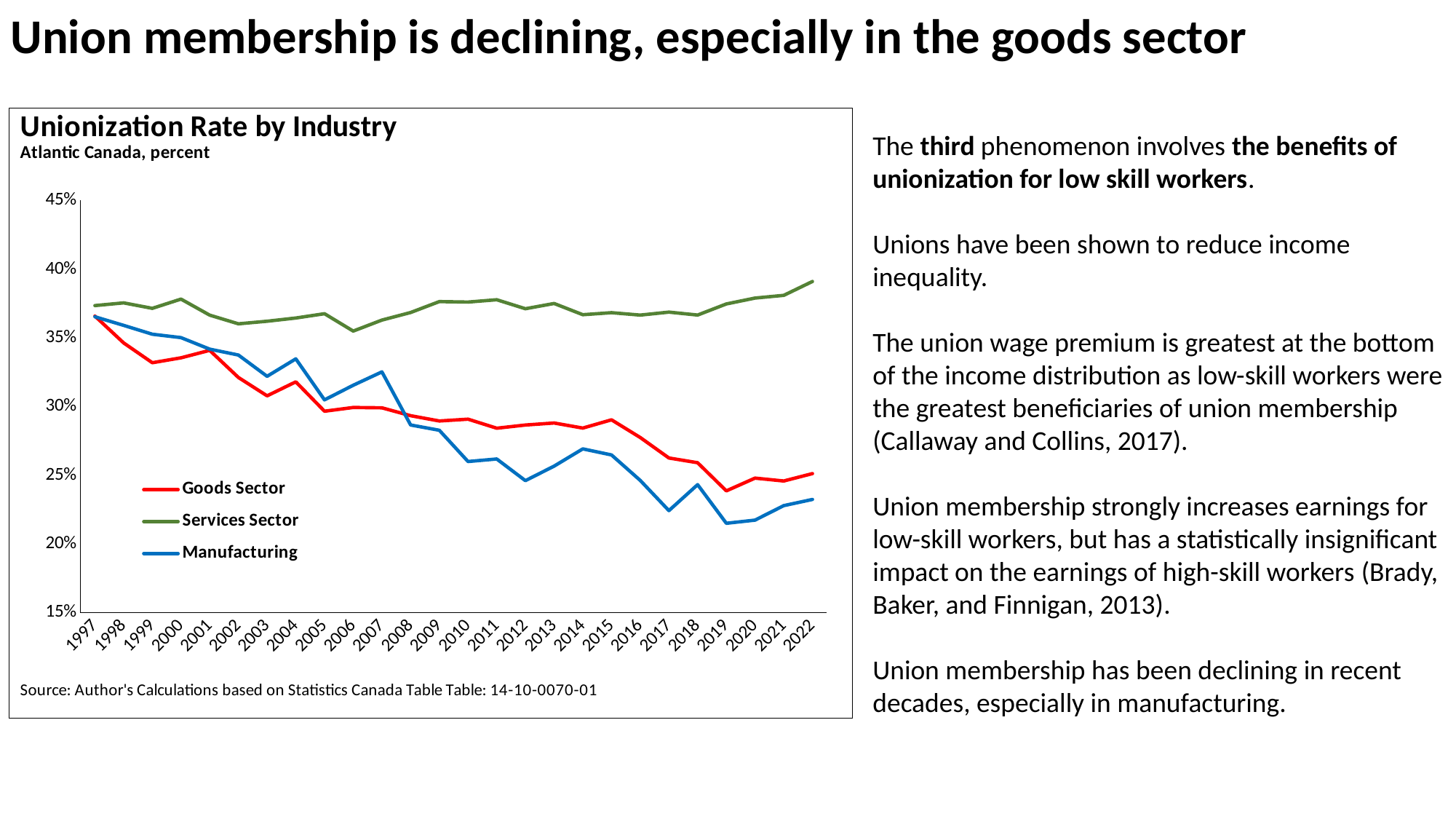
Does the Manufacturing unionization rate rise or fall from 1997 to 2022? fall Is the Manufacturing value in 2019 greater or less than 25%? less In 2022, which is larger: the Services Sector rate or the Goods Sector rate? Services Sector Which series has the lowest unionization rate in 2022? Manufacturing How many years are plotted along the x axis of the chart? 26 What is the title of the chart? Unionization Rate by Industry Is the Services Sector value in 2022 greater or less than 35%? greater Is the Goods Sector value in 1997 greater or less than 35%? greater How many series does the legend of the chart list? 3 Does the Goods Sector unionization rate rise or fall from 1997 to 2022? fall Which series has the highest unionization rate in 2022? Services Sector What kind of chart is shown on the slide? line chart